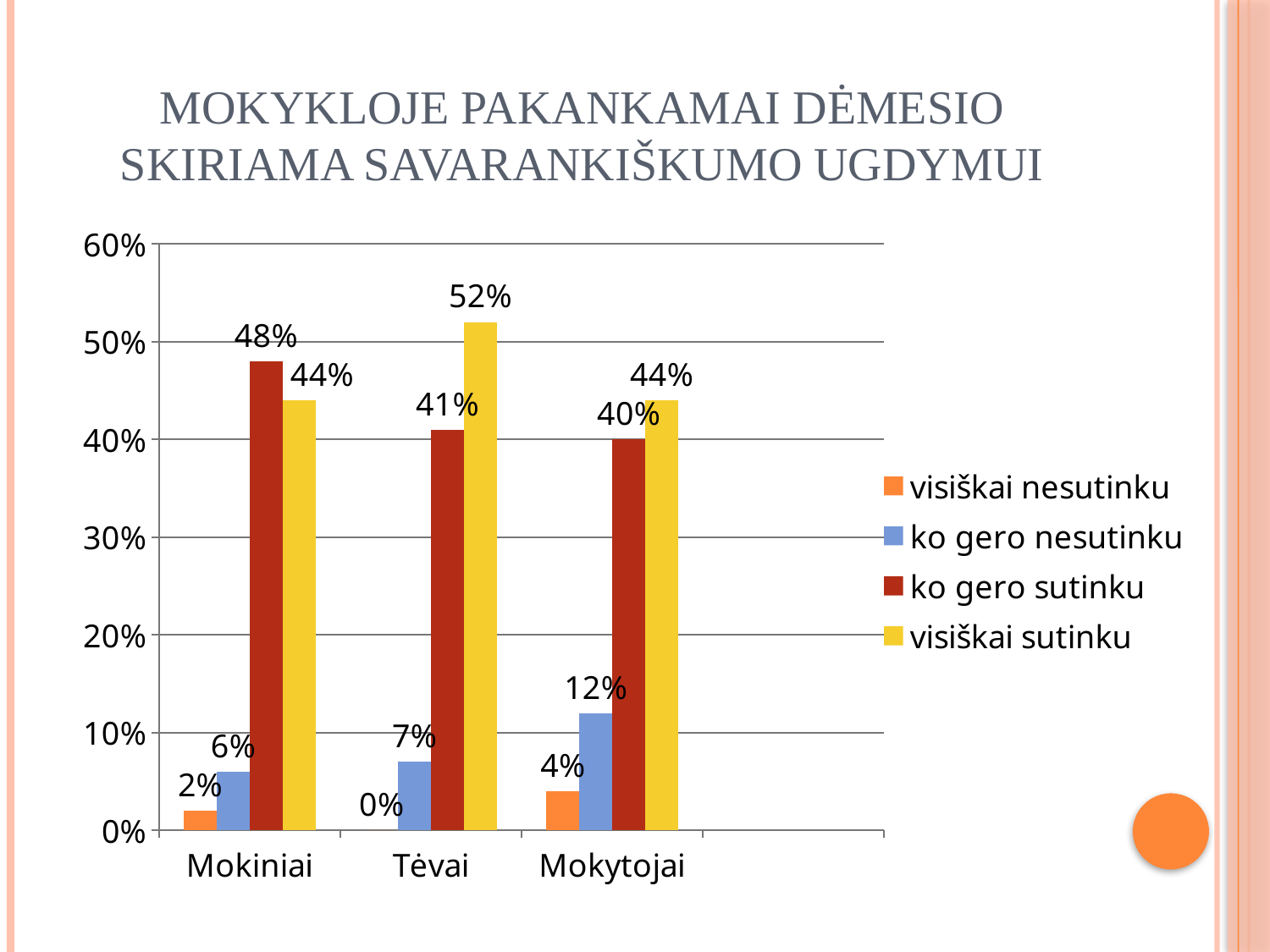
What kind of chart is shown on the slide? Bar chart Which is larger for Mokiniai: 'ko gero sutinku' or 'visiškai sutinku'? ko gero sutinku What is the value for 'ko gero nesutinku' for Mokytojai? 12% How many categories are shown on the x axis? 3 Which category has the highest value for 'visiškai sutinku'? Tėvai What is the value for 'visiškai nesutinku' for Tėvai? 0% How many series does the legend list? 4 Is the value for 'visiškai sutinku' for Tėvai greater or less than 50%? greater What is the value for 'ko gero sutinku' for Mokiniai? 48% What is the difference between 'ko gero sutinku' and 'visiškai sutinku' for Mokytojai? 4% Which category has the lowest value for 'ko gero nesutinku'? Mokiniai What is the value for 'visiškai sutinku' for Tėvai? 52%